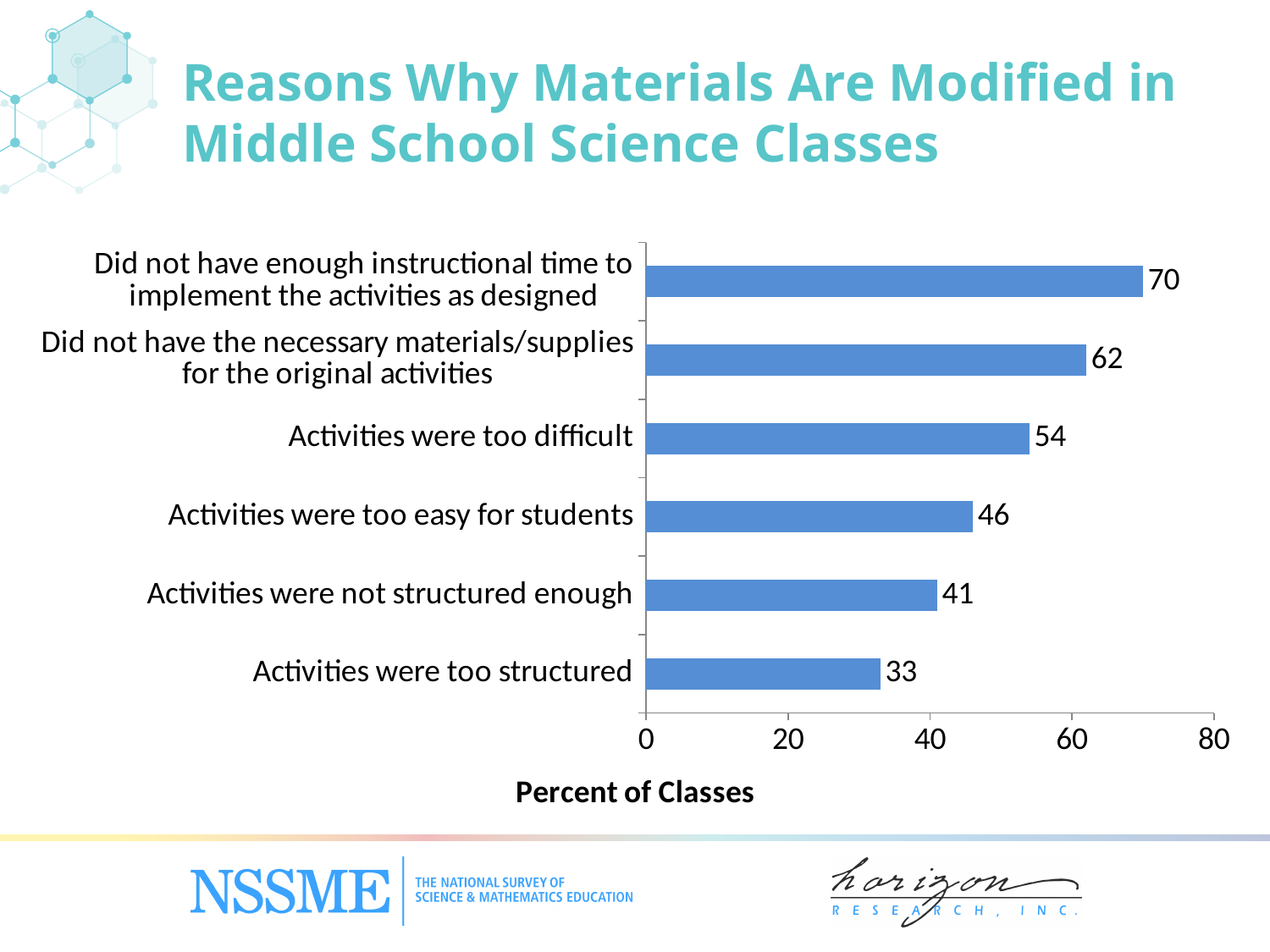
What is the value for 'Activities were too structured'? 33 Is the value for 'Activities were not structured enough' greater or less than 40? greater What is the difference between the highest and lowest values in the chart? 37 Which reason has the lowest percent of classes? Activities were too structured What is the difference between the values for 'Activities were too easy for students' and 'Activities were not structured enough'? 5 What percent of classes modified materials because activities were too difficult? 54 Which reason has the highest percent of classes? Did not have enough instructional time to implement the activities as designed What percent of classes did not have the necessary materials/supplies for the original activities? 62 What is the label of the horizontal axis? Percent of Classes What kind of chart is shown on the slide? Bar chart How many reasons are shown in the chart? 6 Which is larger: the value for 'Activities were too difficult' or the value for 'Activities were too easy for students'? Activities were too difficult